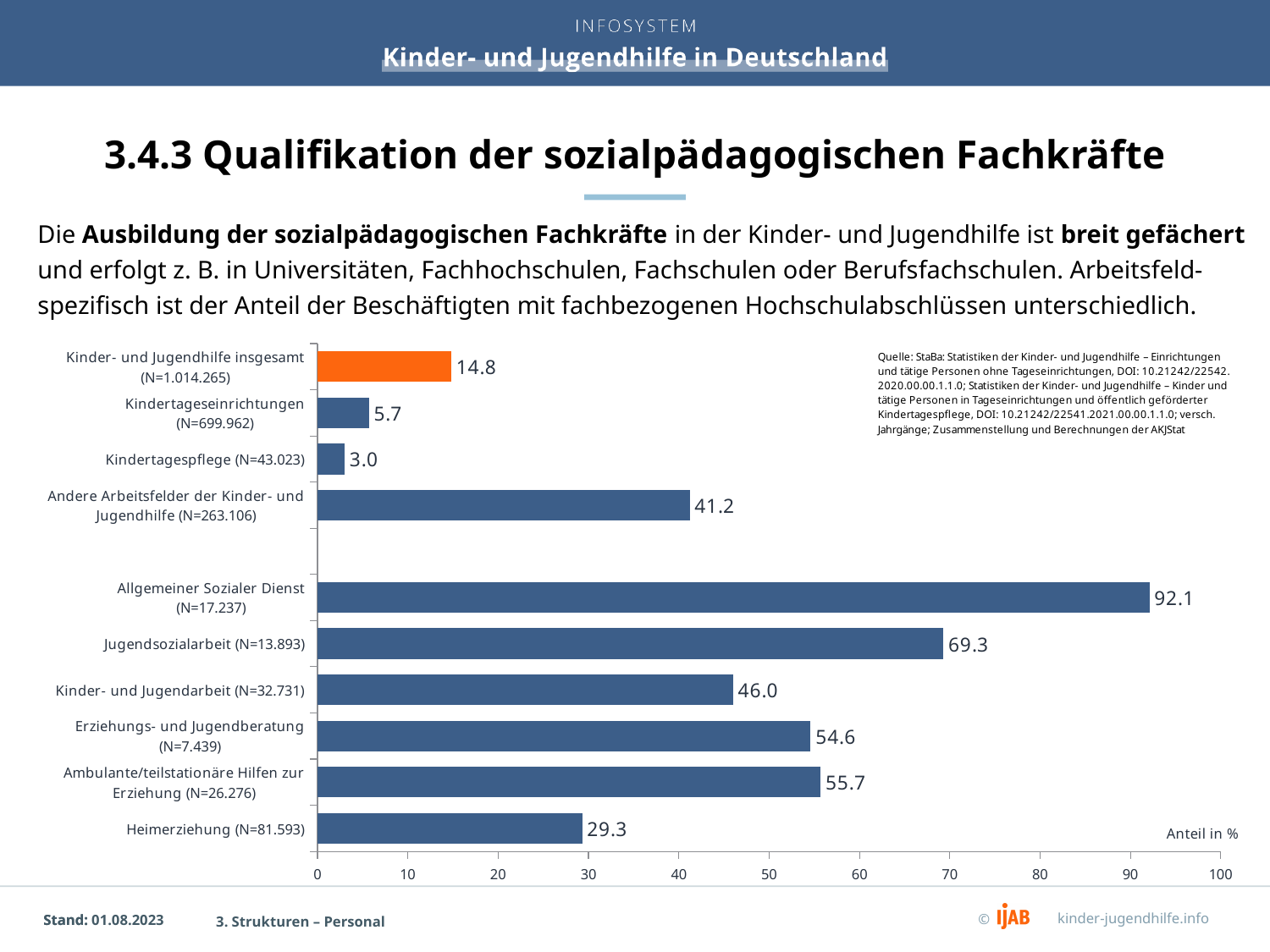
What is the difference between the values for Kinder- und Jugendarbeit and Heimerziehung? 16.7 What is the value shown for Jugendsozialarbeit? 69.3 Which category has the lowest value? Kindertagespflege Which has the larger value, Ambulante/teilstationäre Hilfen zur Erziehung or Erziehungs- und Jugendberatung? Ambulante/teilstationäre Hilfen zur Erziehung How many categories (bars) are shown in the chart? 10 Which category is shown with an orange bar? Kinder- und Jugendhilfe insgesamt What is the difference between the values for Allgemeiner Sozialer Dienst and Jugendsozialarbeit? 22.8 What is the value shown for Heimerziehung? 29.3 What is the value shown for Kindertageseinrichtungen? 5.7 What kind of chart is shown on the slide? Bar chart Which category has the highest value? Allgemeiner Sozialer Dienst What is the value shown for Kinder- und Jugendhilfe insgesamt? 14.8